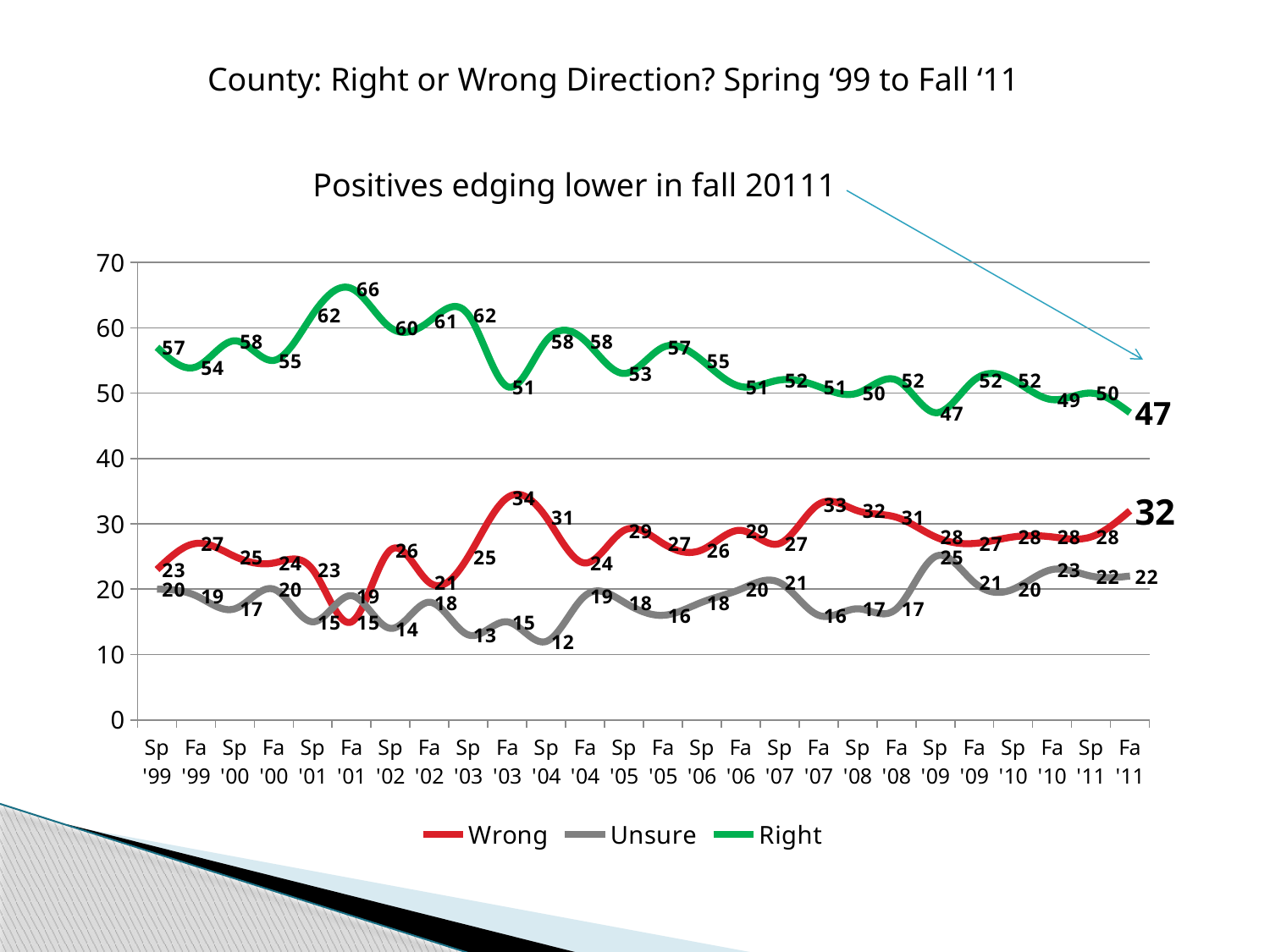
Which is larger for the Right series: the value at Sp '99 or at Fa '99? Sp '99 How many survey periods are plotted along the x axis? 26 What is the value of the Wrong series at Fa '11? 32 What is the value of the Right series at Fa '11? 47 At which survey period does the Wrong series reach its highest value? Fa '03 How many series does the legend list? 3 At which survey period does the Unsure series reach its lowest value? Sp '04 What is the difference between the Right and Wrong values at Fa '11? 15 What is the value of the Unsure series at Sp '09? 25 What kind of chart is shown on the slide? Line chart Overall, does the Right series rise or fall from Sp '99 to Fa '11? Fall At which survey period does the Right series reach its highest value? Fa '01